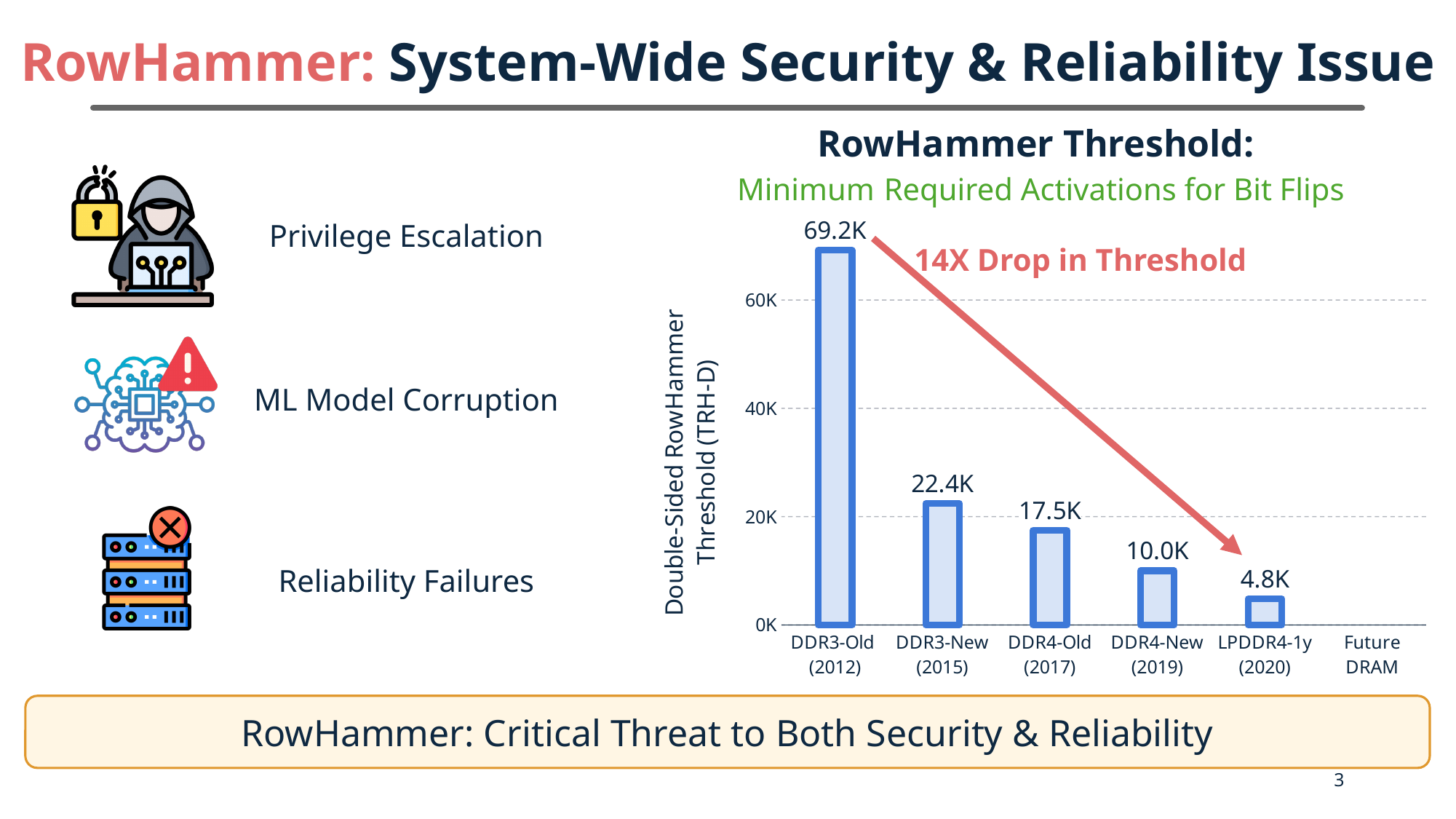
Do the threshold values rise or fall from DDR3-Old (2012) to LPDDR4-1y (2020)? fall Which category has the highest threshold value? DDR3-Old (2012) Which is larger, the value for DDR3-New (2015) or DDR4-Old (2017)? DDR3-New (2015) What is the RowHammer threshold value shown for DDR3-Old (2012)? 69.2K What is the value shown for LPDDR4-1y (2020)? 4.8K How many bars are plotted in the chart? 5 What is the value shown for DDR4-New (2019)? 10.0K Which category with a plotted bar has the lowest threshold value? LPDDR4-1y (2020) What is the difference between the values for DDR4-New (2019) and LPDDR4-1y (2020)? 5.2K Is the value for DDR4-Old (2017) greater or less than 20K? less What is the difference between the values for DDR3-Old (2012) and DDR3-New (2015)? 46.8K What kind of chart is shown on the slide? bar chart